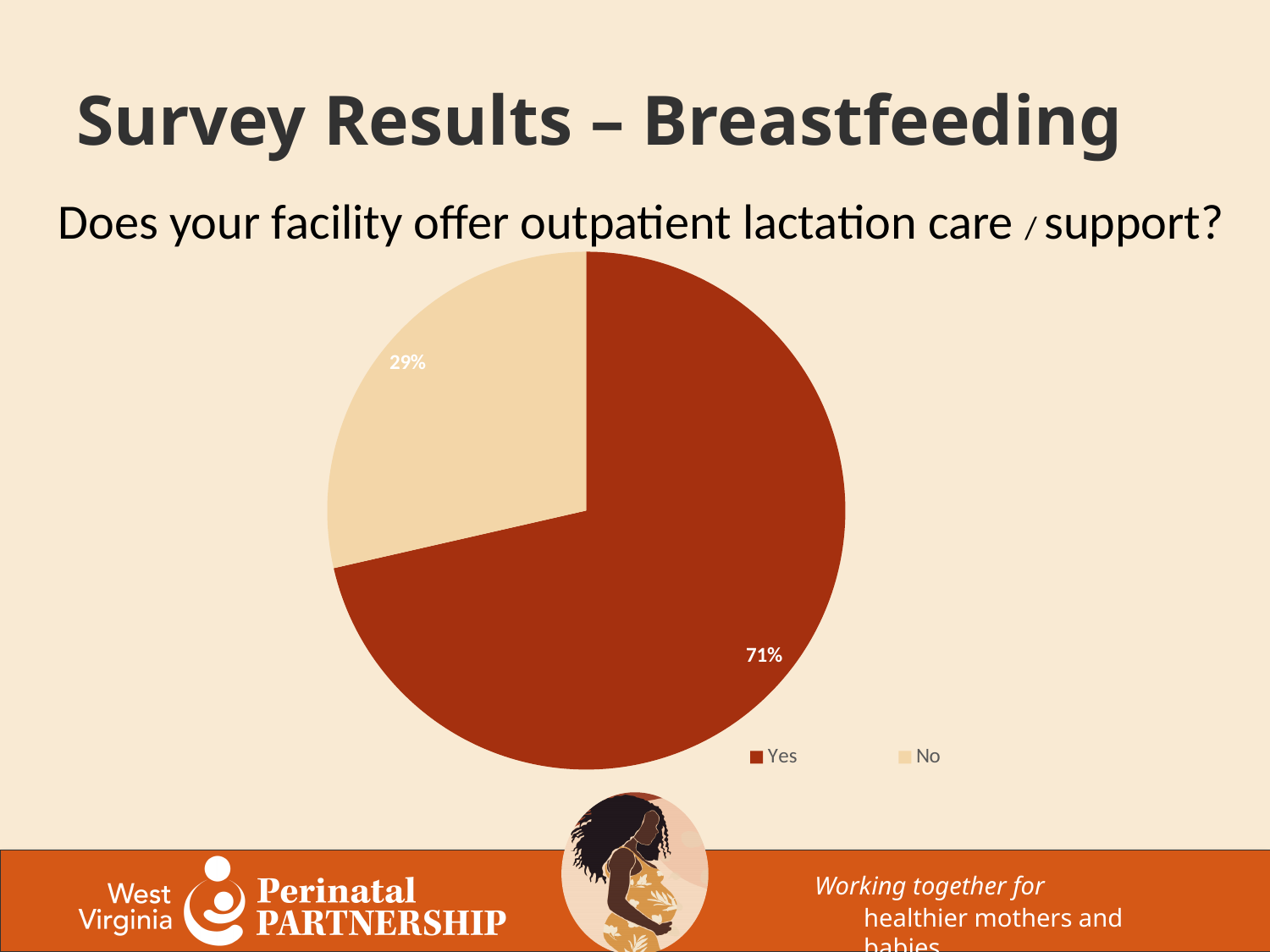
What share of the pie does the "No" slice represent? 29% Which response has the largest share of the pie? Yes How many slices does the pie chart have? 2 Which response has the smallest share of the pie? No What kind of chart is shown on the slide? pie chart What percentage of facilities answered "No"? 29% Which legend entry is shown in dark red? Yes What is the difference in percentage points between the "Yes" and "No" responses? 42 What percentage of facilities answered "Yes" to offering outpatient lactation care / support? 71% What question does the pie chart present results for? Does your facility offer outpatient lactation care / support? Which is larger, the share for "Yes" or the share for "No"? Yes How many entries does the legend list? 2